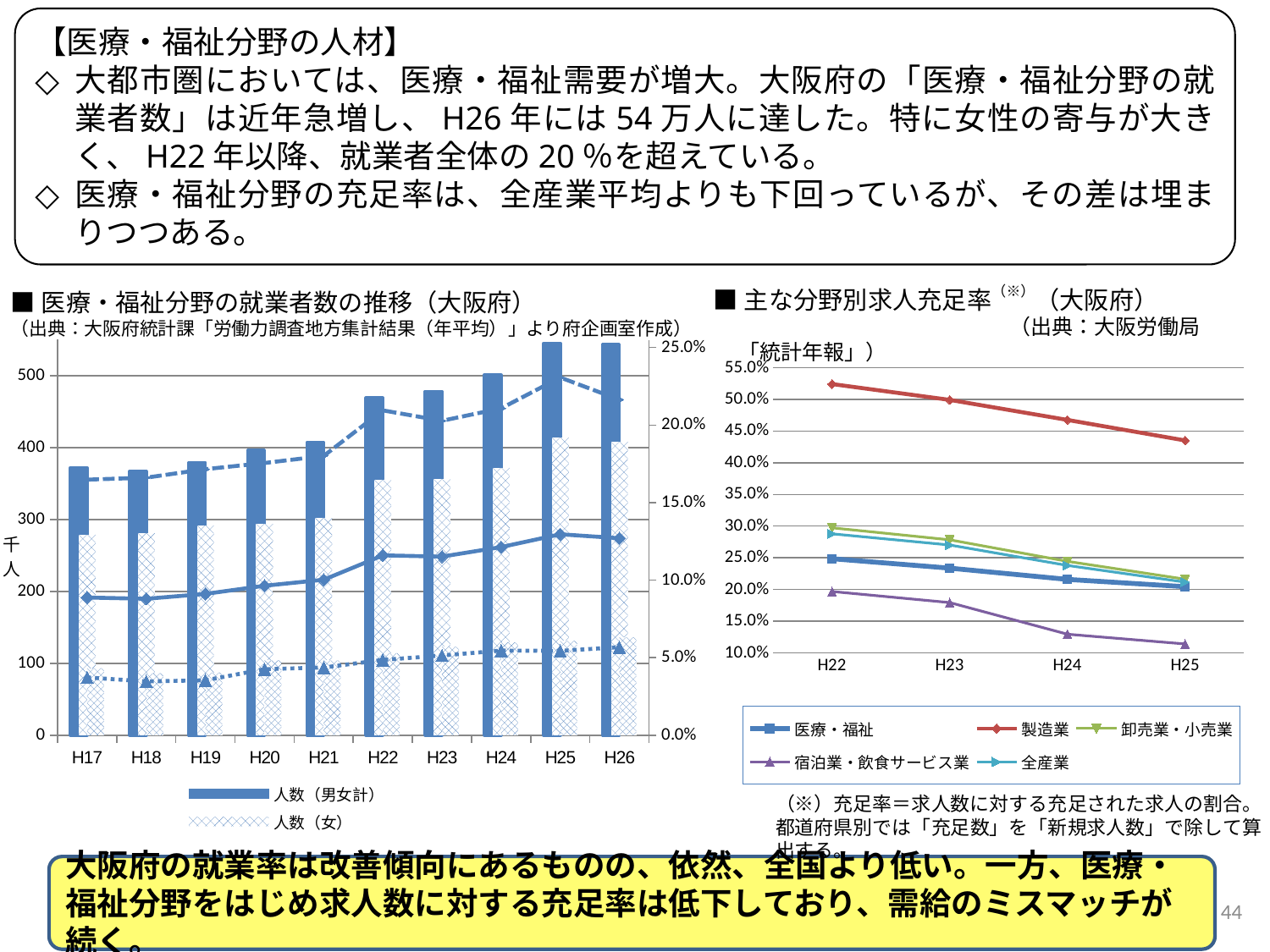
On the chart titled 主な分野別求人充足率（大阪府）, how many years are shown on the x axis? 4 On the chart titled 主な分野別求人充足率（大阪府）, is the value for 宿泊業・飲食サービス業 in H23 greater or less than 20.0%? less On the chart titled 医療・福祉分野の就業者数の推移（大阪府）, is the 人数（男女計） bar for H17 greater or less than 400? less On the chart titled 主な分野別求人充足率（大阪府）, does the value for 製造業 rise or fall from H22 to H25? fall On the chart titled 主な分野別求人充足率（大阪府）, is the value for 製造業 in H22 greater or less than 50.0%? greater On the chart titled 医療・福祉分野の就業者数の推移（大阪府）, do the 人数（男女計） bars generally rise or fall from H17 to H26? rise On the chart titled 医療・福祉分野の就業者数の推移（大阪府）, how many years are shown on the x axis? 10 On the chart titled 主な分野別求人充足率（大阪府）, which series has the highest value in H22? 製造業 On the chart titled 主な分野別求人充足率（大阪府）, how many series does the legend list? 5 On the chart titled 主な分野別求人充足率（大阪府）, which series has the lowest value in H25? 宿泊業・飲食サービス業 On the chart titled 主な分野別求人充足率（大阪府）, which is larger in H24, 製造業 or 医療・福祉? 製造業